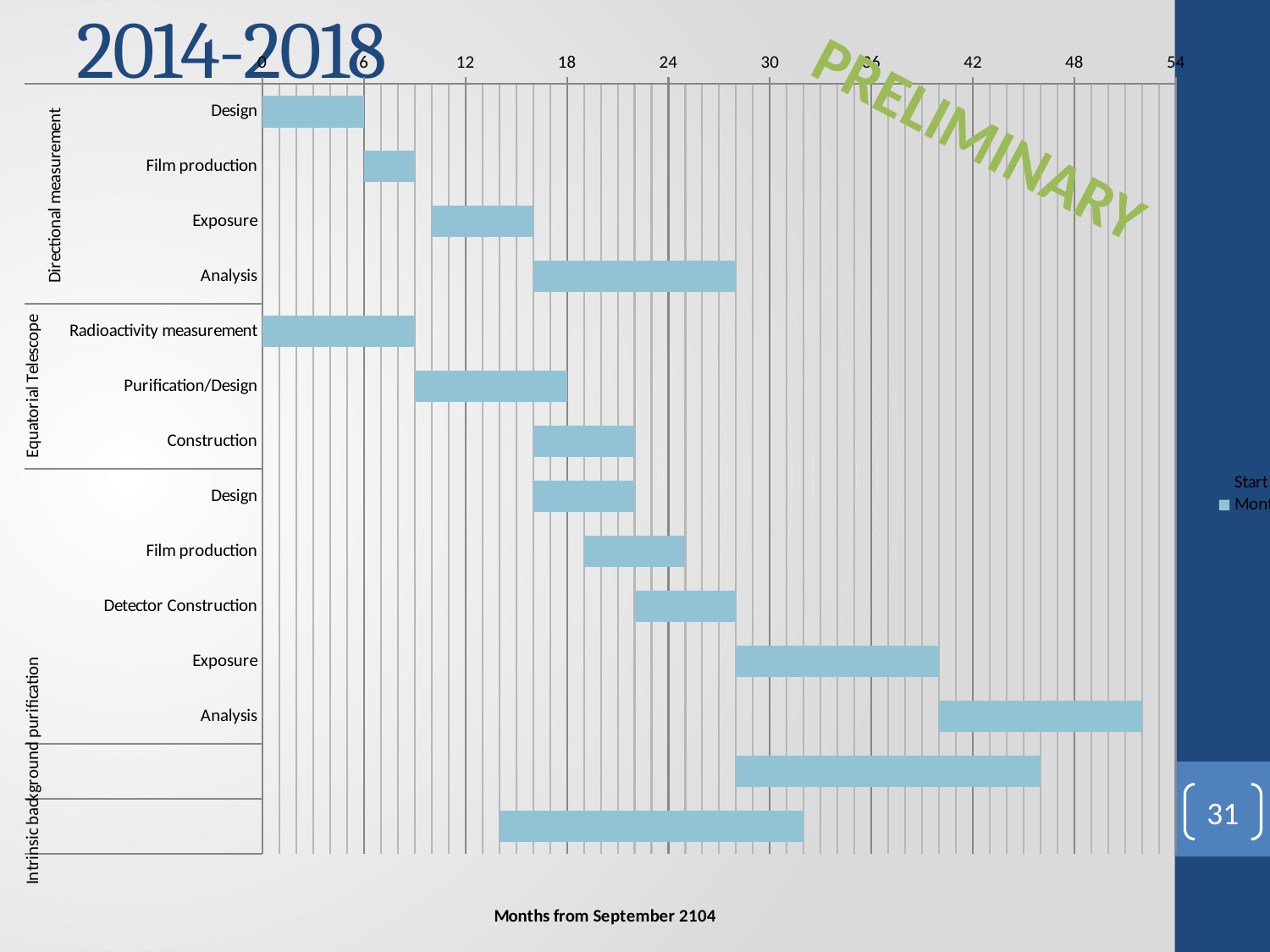
Is the end of the Exposure bar in the Intrinsic background purification group greater or less than 42 months? less What is the x-axis title of the chart? Months from September 2104 Which task in the Directional measurement group has the shortest bar? Film production What is the highest tick value shown on the x axis? 54 At which month does the Design bar in the Directional measurement group end? 6 How many task groups are labelled along the left side of the chart? 3 At which month does the Purification/Design bar in the Equatorial Telescope group end? 18 What kind of chart is shown on the slide? bar chart In the Intrinsic background purification group, which starts later: Exposure or Analysis? Analysis Is the end of the Analysis bar in the Intrinsic background purification group greater or less than 48 months? greater Which task in the Directional measurement group has the longest bar? Analysis Is the end of the Film production bar in the Directional measurement group greater or less than 12 months? less